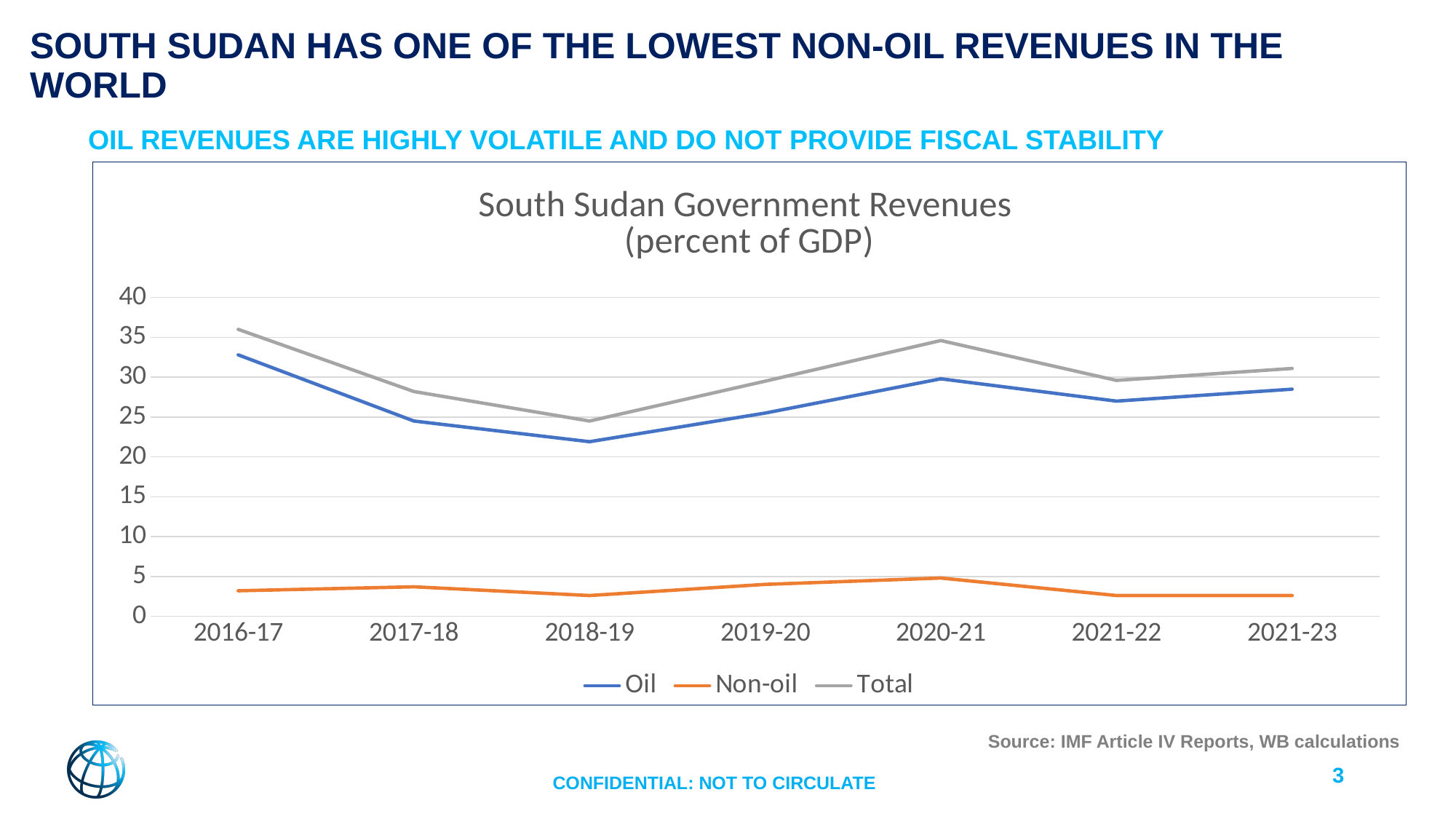
Is the Total value for 2016-17 greater or less than 30? greater How many time periods are plotted along the x axis? 7 What kind of chart is shown on the slide? line chart In which period is the Total revenue series at its highest? 2016-17 In which period does the Non-oil series reach its highest value? 2020-21 Which is larger in 2019-20, Oil revenue or Non-oil revenue? Oil What is the title of the chart? South Sudan Government Revenues (percent of GDP) Does the Oil series rise or fall from 2016-17 to 2018-19? fall Is the Oil value for 2018-19 greater or less than 25? less How many series does the legend list? 3 Is the Non-oil value for 2020-21 greater or less than 10? less In which period is the Oil revenue series at its lowest? 2018-19